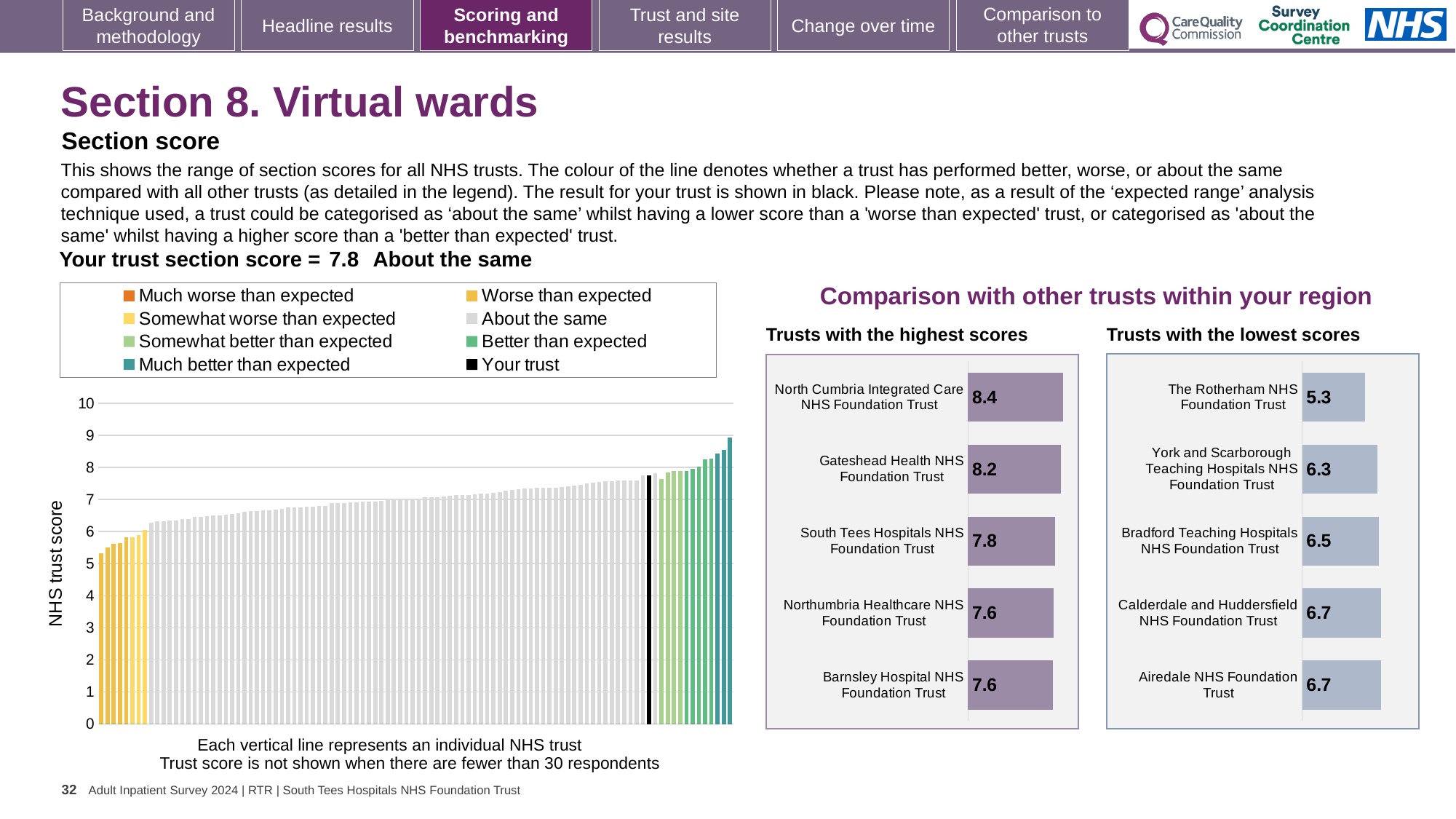
In the 'Trusts with the lowest scores' chart, which has the higher score: Bradford Teaching Hospitals NHS Foundation Trust or York and Scarborough Teaching Hospitals NHS Foundation Trust? Bradford Teaching Hospitals NHS Foundation Trust In the main NHS trust score chart on the left, what is the section score for your trust? 7.8 In the 'Trusts with the highest scores' chart, what is the score for North Cumbria Integrated Care NHS Foundation Trust? 8.4 In the 'Trusts with the lowest scores' chart, what is the difference between the scores of Airedale NHS Foundation Trust and The Rotherham NHS Foundation Trust? 1.4 How many trusts are shown in the 'Trusts with the lowest scores' chart? 5 In the main NHS trust score chart on the left, do the values rise or fall from left to right? Rise In the 'Trusts with the highest scores' chart, what is the difference between the scores of North Cumbria Integrated Care NHS Foundation Trust and South Tees Hospitals NHS Foundation Trust? 0.6 In the 'Trusts with the lowest scores' chart, which trust has the lowest score? The Rotherham NHS Foundation Trust What kind of chart is the main NHS trust score chart on the left? Bar chart In the 'Trusts with the lowest scores' chart, what is the score for The Rotherham NHS Foundation Trust? 5.3 In the 'Trusts with the highest scores' chart, which trust has the highest score? North Cumbria Integrated Care NHS Foundation Trust How many entries does the legend of the main NHS trust score chart on the left list? 8